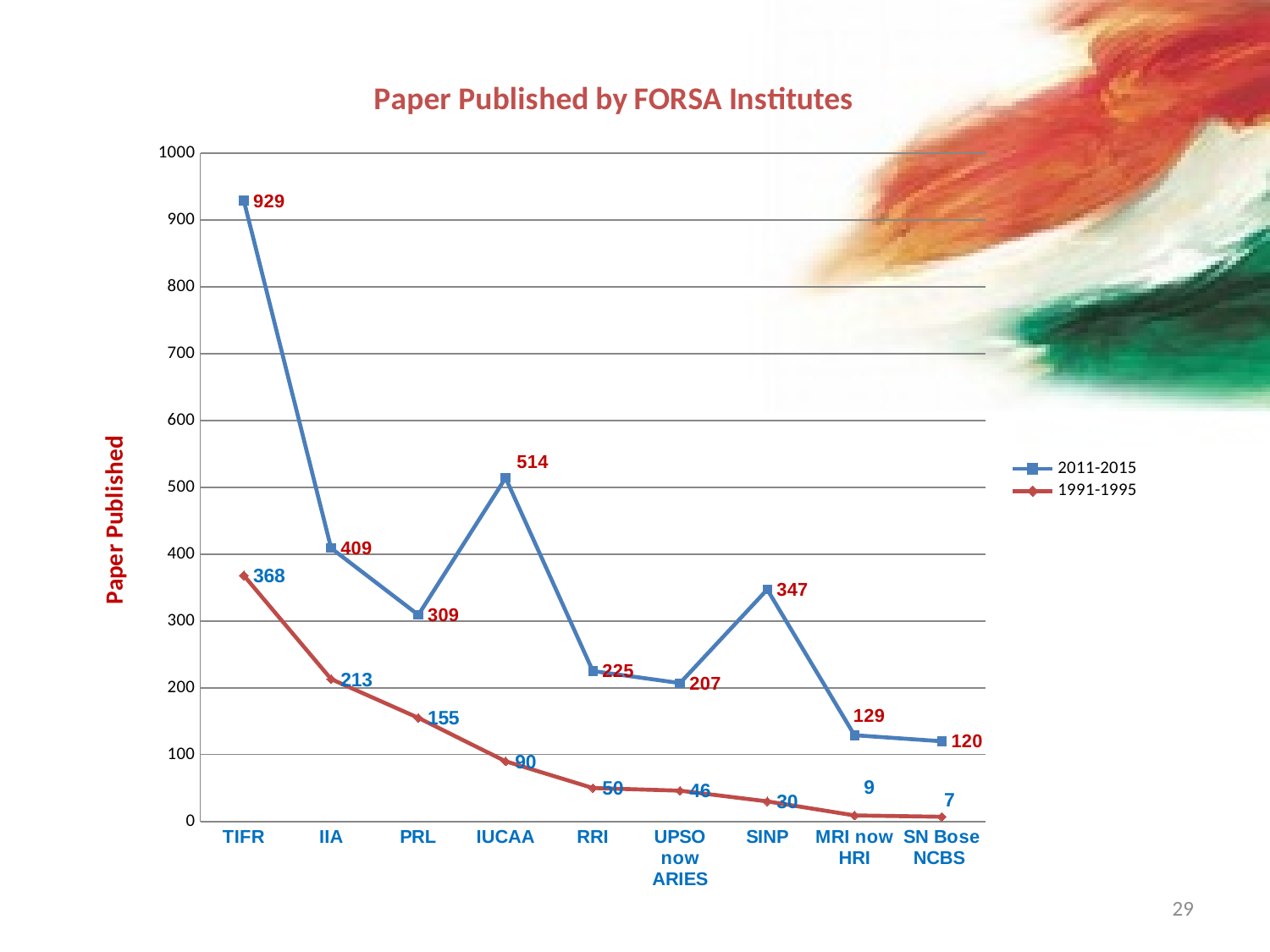
Which is larger for PRL: the 2011-2015 value or the 1991-1995 value? 2011-2015 What is the title of the chart? Paper Published by FORSA Institutes What is the number of papers published by TIFR in 2011-2015? 929 Does the 1991-1995 series rise or fall from TIFR to SN Bose NCBS? fall Which institute has the lowest value in the 2011-2015 series? SN Bose NCBS What is the difference between the 2011-2015 and 1991-1995 values for IIA? 196 What is the value for SINP in the 2011-2015 series? 347 What type of chart is shown on the slide? line chart How many institutes are shown on the x axis? 9 What is the number of papers published by IUCAA in 1991-1995? 90 Which institute has the highest value in the 1991-1995 series? TIFR How many series does the legend list? 2